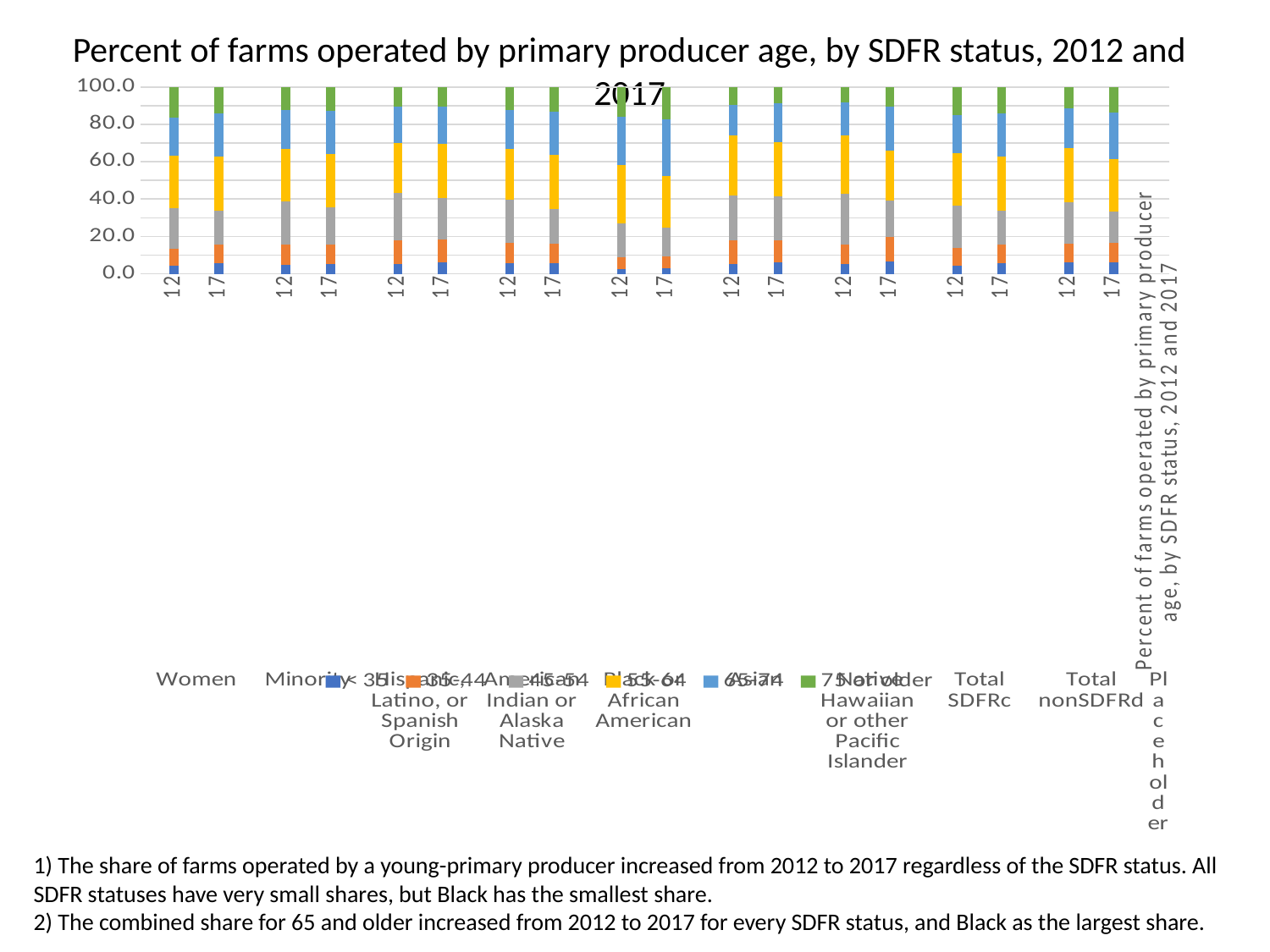
What kind of chart is shown on the slide? stacked bar chart Which SDFR status group has the smallest share of farms operated by producers under 35? Black or African American Which two years are compared for each SDFR status group? 2012 and 2017 What is the title of the chart? Percent of farms operated by primary producer age, by SDFR status, 2012 and 2017 What is the highest value shown on the y axis? 100.0 How many SDFR status groups are shown along the x axis? 9 In the Black or African American 2017 bar, is the top of the 55-64 segment greater or less than 60? less How many series does the legend list? 6 In the Black or African American 2012 bar, is the top of the 45-54 segment greater or less than 40? less How many bars are plotted in total on the chart? 18 Did the combined share of producers aged 65 and older rise or fall from 2012 to 2017 for each SDFR status? rise Which SDFR status group has the largest combined share of producers aged 65 and older? Black or African American